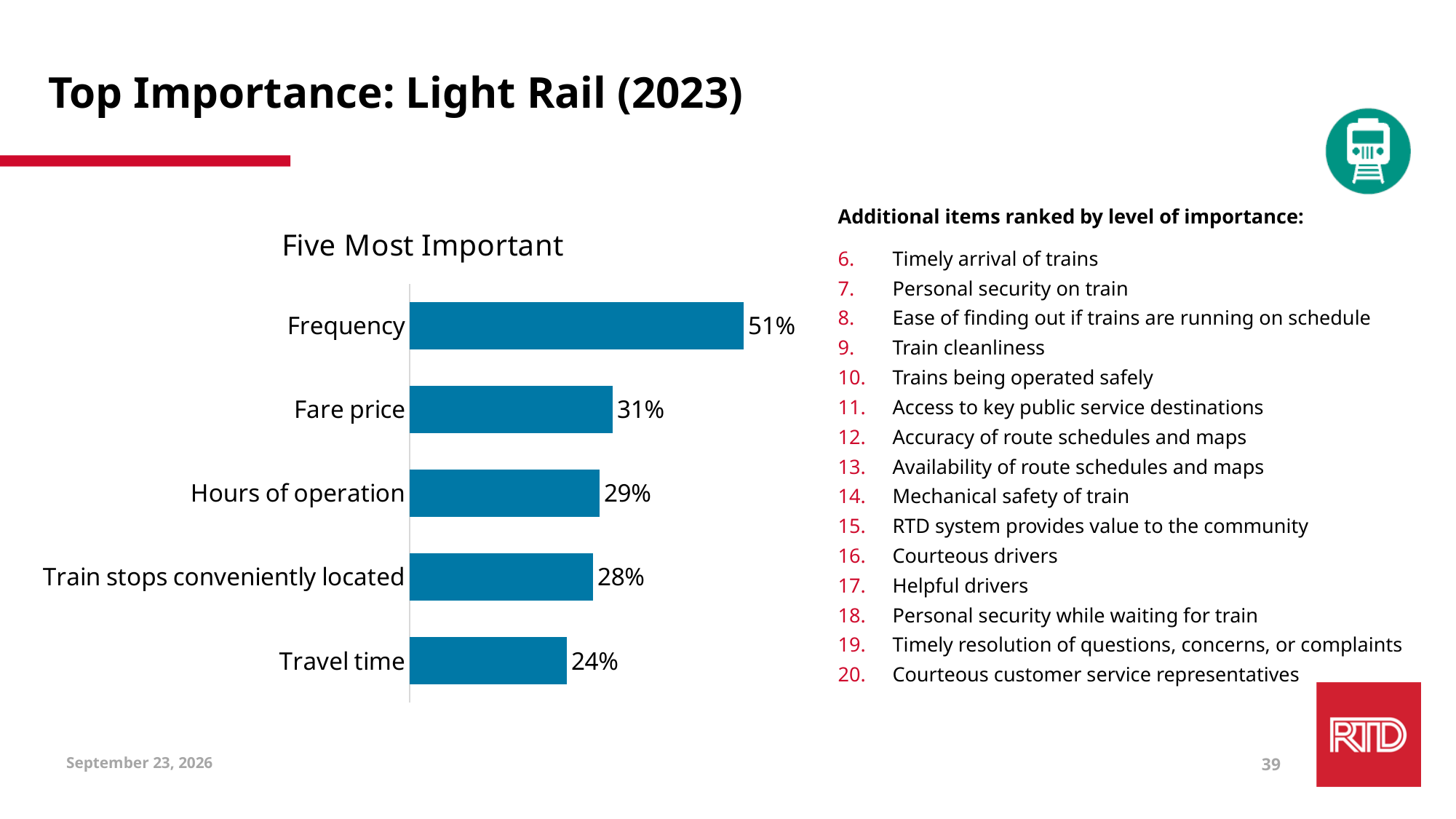
What is the difference between the values for Frequency and Fare price? 20% What is the value for Frequency? 51% How many categories are shown in the chart? 5 What is the title of the chart? Five Most Important Which category has the lowest value? Travel time What is the difference between the values for Hours of operation and Travel time? 5% What is the value for Fare price? 31% What kind of chart is shown on the slide? Bar chart What is the value for Travel time? 24% Which is larger, the value for Fare price or the value for Hours of operation? Fare price Which category has the highest value? Frequency What is the value for Train stops conveniently located? 28%